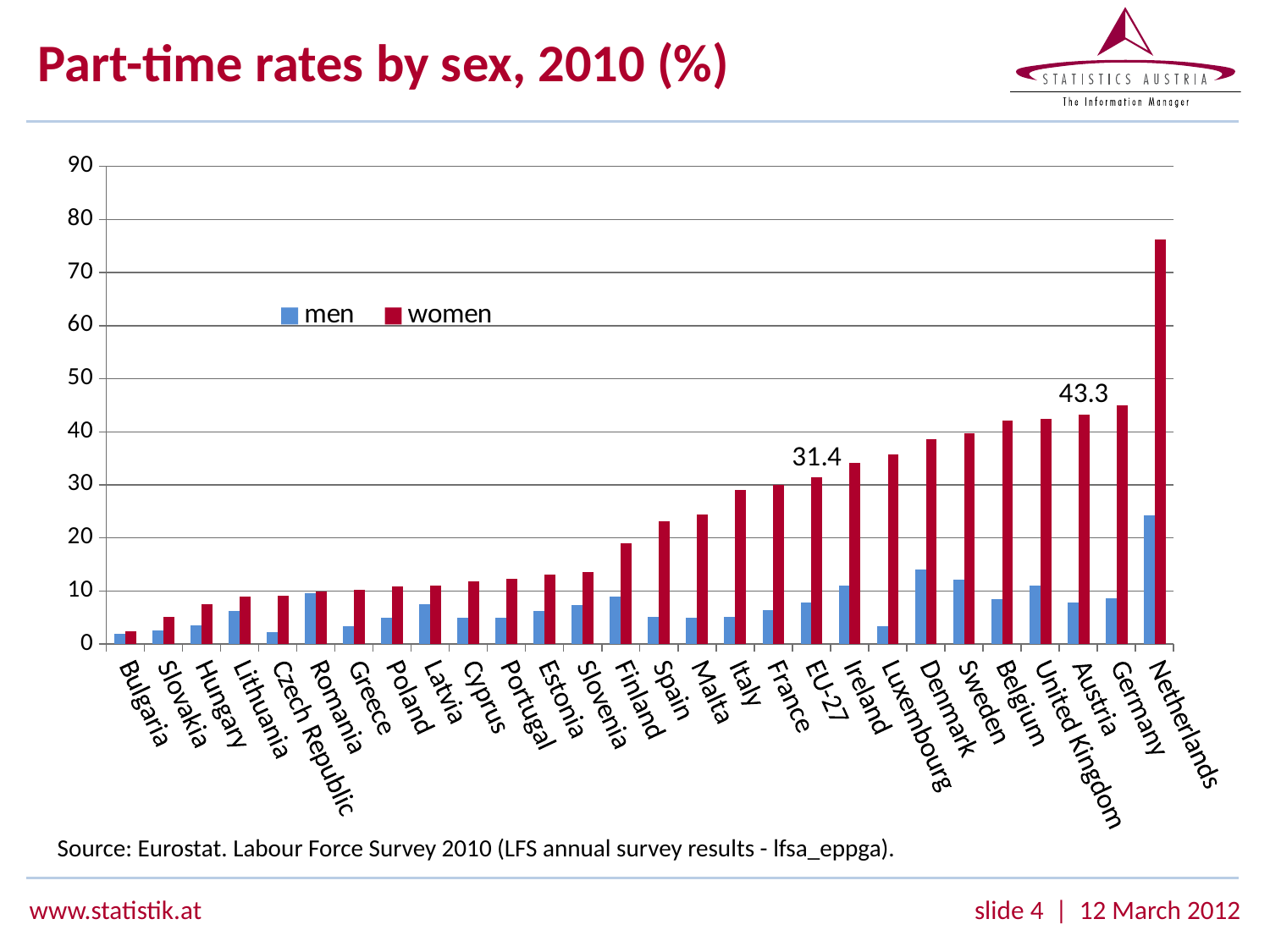
Is the part-time rate for women in the Netherlands greater or less than 70? greater Which two series are listed in the legend? men and women What is the part-time rate for women in the EU-27? 31.4 Which country has the highest part-time rate for men? Netherlands Which country has the highest part-time rate for women? Netherlands How many categories are shown along the x axis? 28 How many series does the legend list? 2 Do the values for women rise or fall from left to right along the x axis? rise What is the part-time rate for women in Austria? 43.3 What is the difference between the women's part-time rate in Austria and in the EU-27? 11.9 Which country has the lowest part-time rate for women? Bulgaria What kind of chart is shown on the slide? bar chart